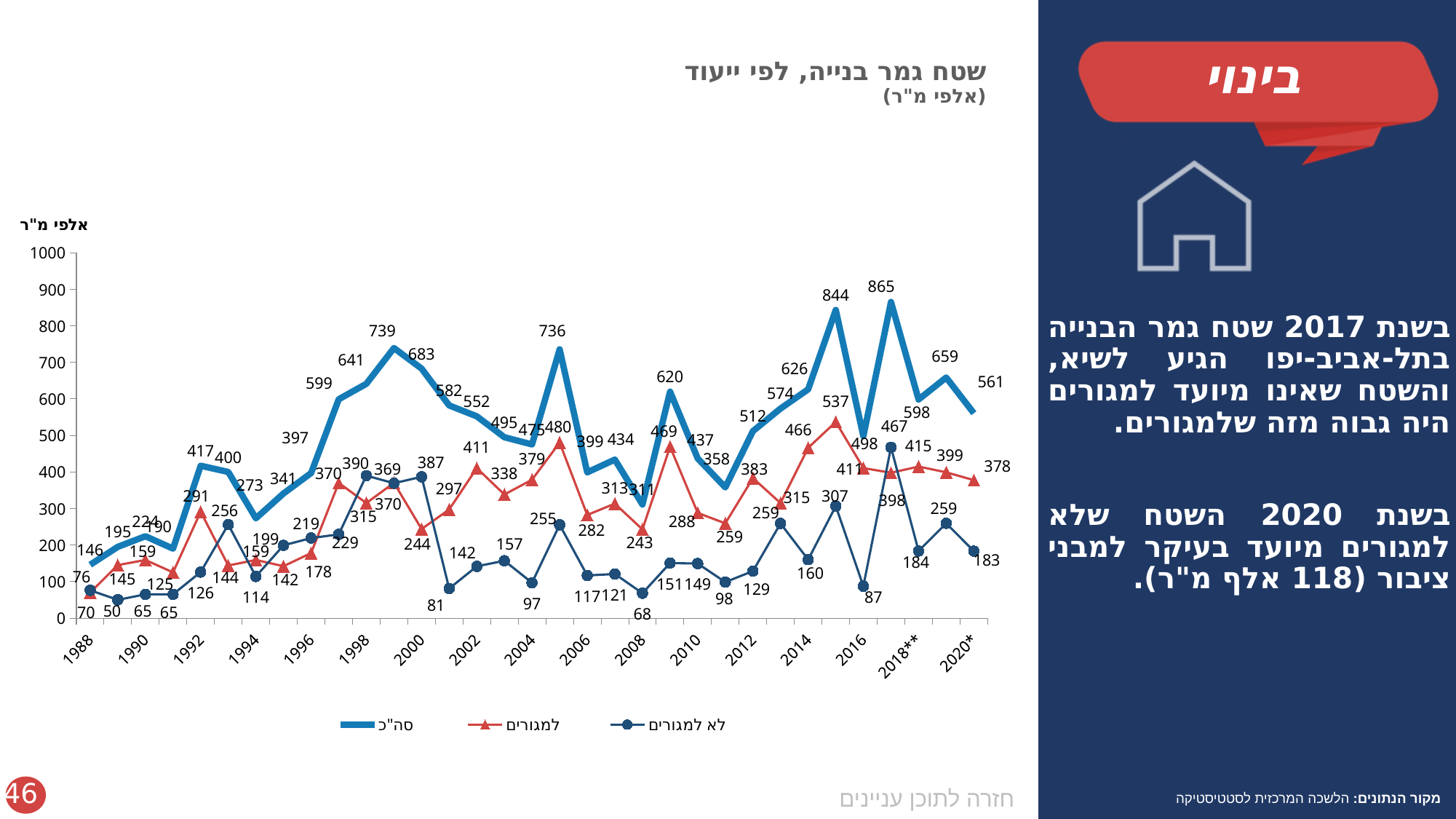
In 2017, which is larger: the למגורים value or the לא למגורים value? לא למגורים In which year is the סה"כ series at its lowest value? 1988 In which year does the סה"כ series reach its highest value? 2017 Is the סה"כ value in 2015 greater or less than 800? greater Does the סה"כ series rise or fall from 2017 to 2020? Fall What is the value of the למגורים series in 2015? 537 What is the value of the סה"כ series in 2017? 865 What is the difference between the סה"כ values in 2017 and 2020? 304 How many series does the legend list? 3 What type of chart is shown on the slide? Line chart What is the title of the chart? שטח גמר בנייה, לפי ייעוד (אלפי מ"ר) What is the value of the לא למגורים series in 2020? 183